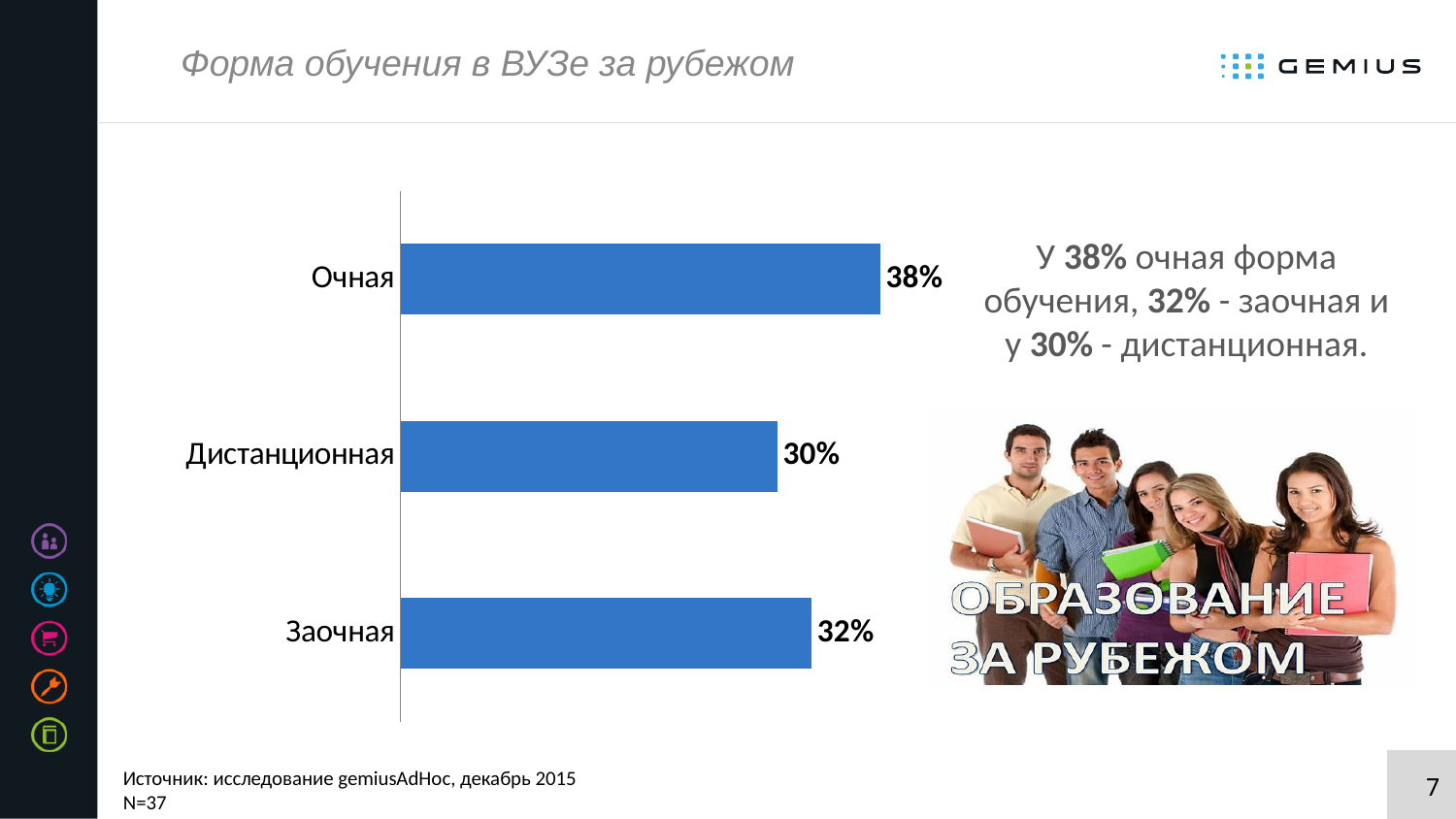
What is the difference between the values for Заочная and Дистанционная? 2% How many categories are shown in the chart? 3 What is the difference between the values for Очная and Заочная? 6% Which category has the lowest value? Дистанционная What is the value for Заочная? 32% What is the title of the slide containing the chart? Форма обучения в ВУЗе за рубежом Which category has the highest value? Очная What kind of chart is shown on the slide? bar chart What is the value for Очная? 38% Which is larger, the value for Очная or the value for Дистанционная? Очная What colour are the bars in the chart? blue What is the value for Дистанционная? 30%